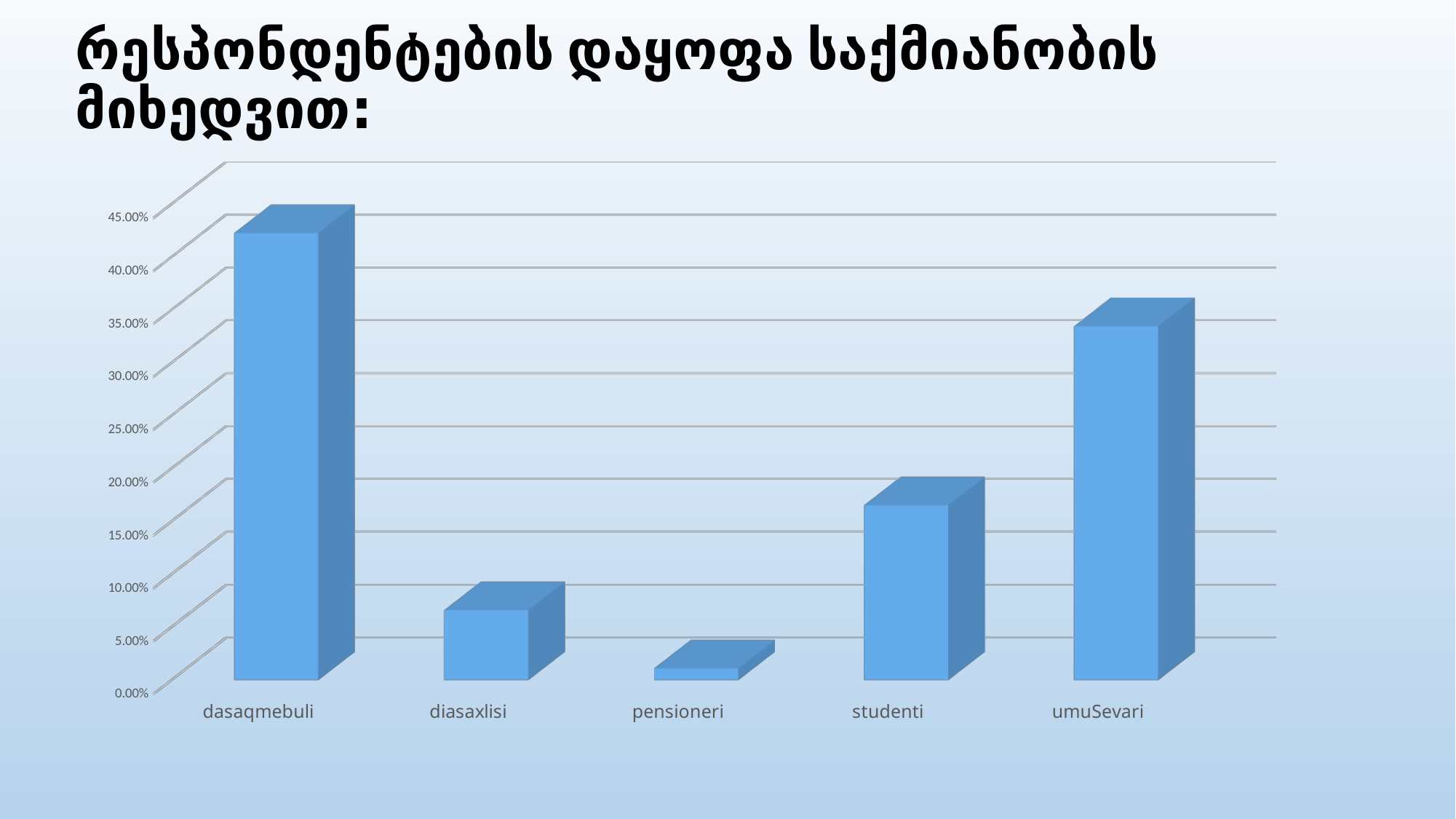
Which category has the highest value in the chart? dasaqmebuli How many categories are shown on the x axis of the chart? 5 Is the value for dasaqmebuli greater or less than 40.00%? greater Which is larger, the value for studenti or the value for diasaxlisi? studenti Which category has the lowest value in the chart? pensioneri Is the value for studenti greater or less than 20.00%? less Is the value for umuSevari greater or less than 30.00%? greater What kind of chart is shown on the slide? bar chart What is the highest value labelled on the vertical axis of the chart? 45.00% Which is larger, the value for umuSevari or the value for dasaqmebuli? dasaqmebuli